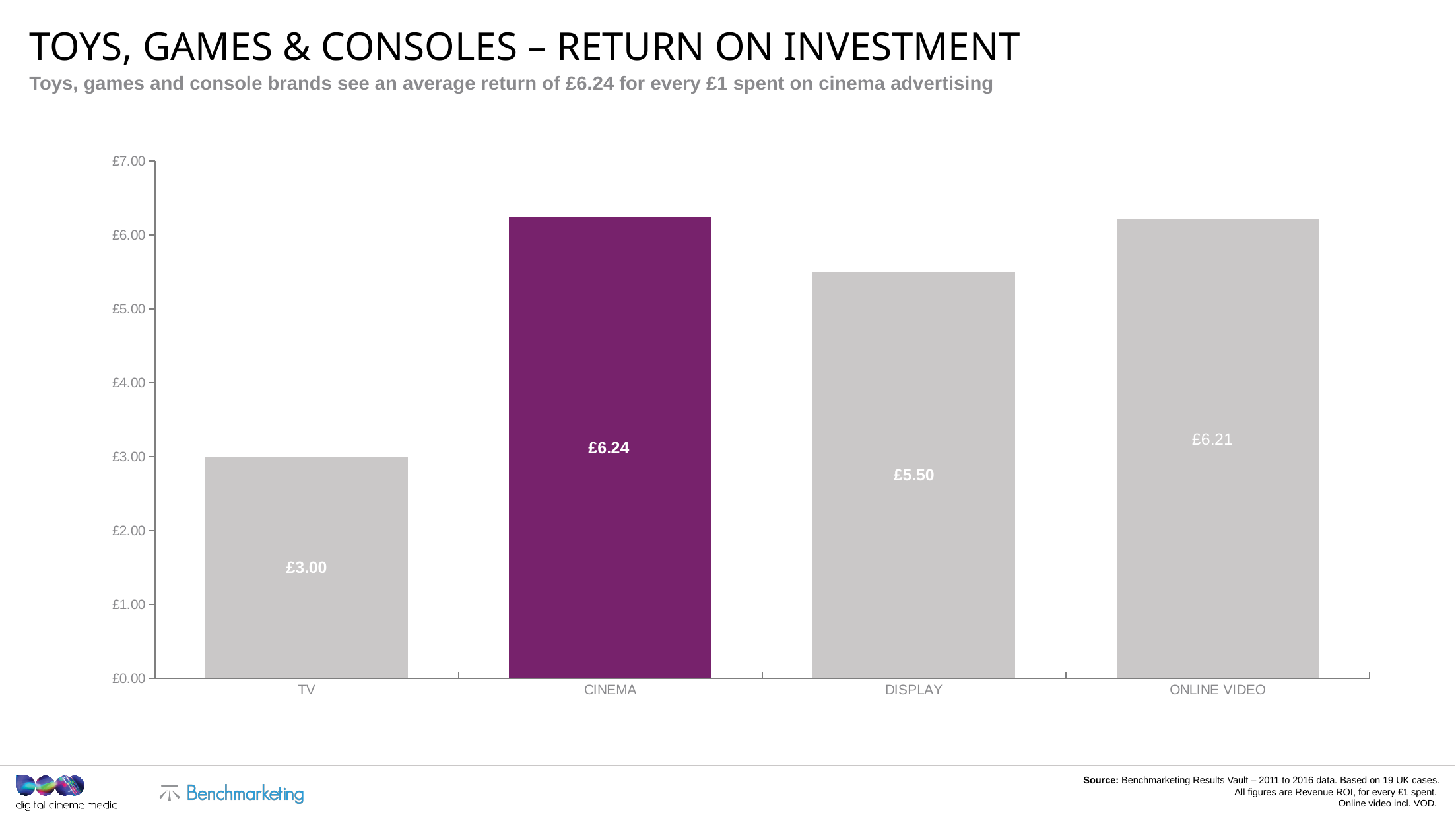
What is the return on investment value for TV? £3.00 Which bar is highlighted in purple? Cinema Is the value for Display greater or less than £5.00? greater What is the return on investment value for Display? £5.50 Which is larger, the value for Display or the value for TV? Display Which category has the lowest return on investment? TV What is the return on investment value for Online Video? £6.21 What kind of chart is shown on the slide? Bar chart How many categories are shown on the chart? 4 What is the return on investment value for Cinema? £6.24 What is the difference between the Cinema and Display values? £0.74 What is the difference between the Cinema and TV values? £3.24